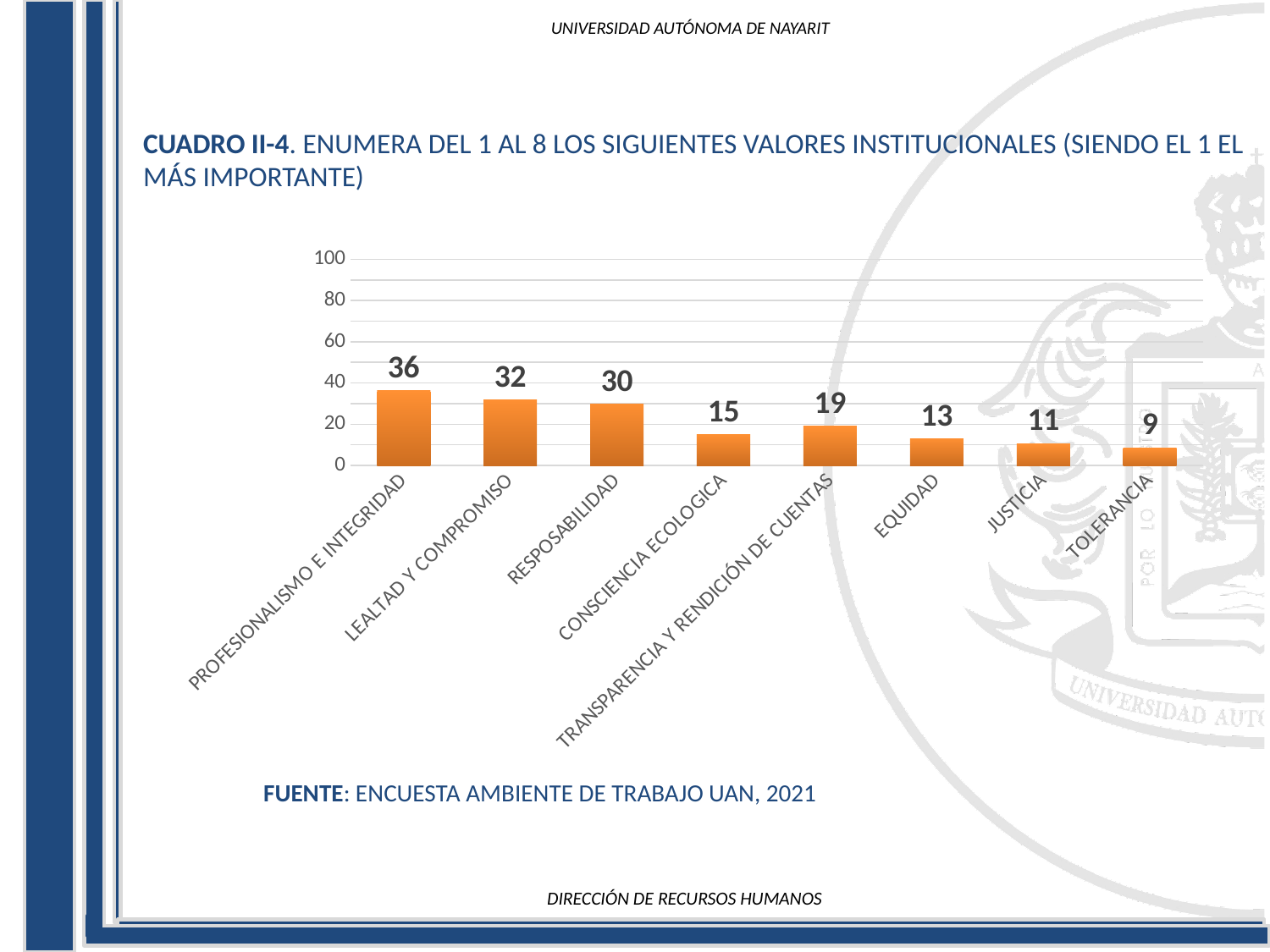
What is the difference between the values for LEALTAD Y COMPROMISO and RESPOSABILIDAD? 2 How many categories are shown in the chart? 8 Which category has the lowest value? TOLERANCIA What is the difference between the values for PROFESIONALISMO E INTEGRIDAD and TOLERANCIA? 27 Which is larger, the value for CONSCIENCIA ECOLOGICA or the value for EQUIDAD? CONSCIENCIA ECOLOGICA What is the value for TOLERANCIA? 9 Is the value for JUSTICIA greater or less than 20? less What is the value for PROFESIONALISMO E INTEGRIDAD? 36 What kind of chart is shown on the slide? bar chart Which category has the highest value? PROFESIONALISMO E INTEGRIDAD What source is cited below the chart? ENCUESTA AMBIENTE DE TRABAJO UAN, 2021 What is the value for TRANSPARENCIA Y RENDICIÓN DE CUENTAS? 19